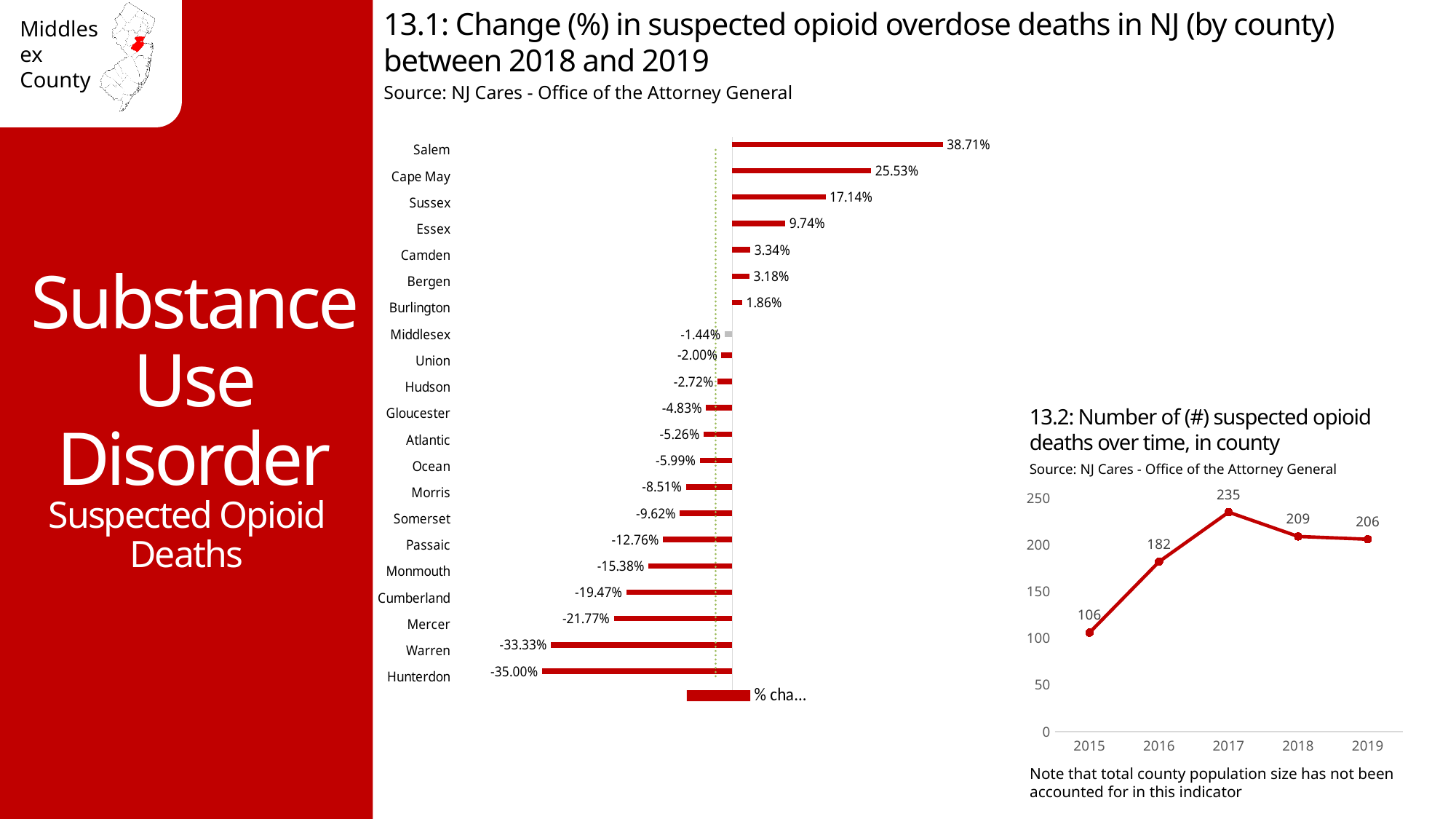
In chart 13.1, which has a larger percentage change, Essex or Camden? Essex What kind of chart is chart 13.1? Bar chart In chart 13.2, how many suspected opioid deaths were there in 2017? 235 In chart 13.2, what is the difference in suspected opioid deaths between 2016 and 2015? 76 In chart 13.1, how many counties are shown? 21 In chart 13.2, how many data points are plotted? 5 In chart 13.1, which county has the lowest percentage change? Hunterdon In chart 13.1, what is the difference between the values for Cape May and Sussex? 8.39% In chart 13.2, which year has the lowest number of suspected opioid deaths? 2015 In chart 13.1, what is the percentage change in suspected opioid overdose deaths for Middlesex? -1.44% In chart 13.1, which county has the highest percentage change? Salem In chart 13.1, what is the percentage change for Salem? 38.71%